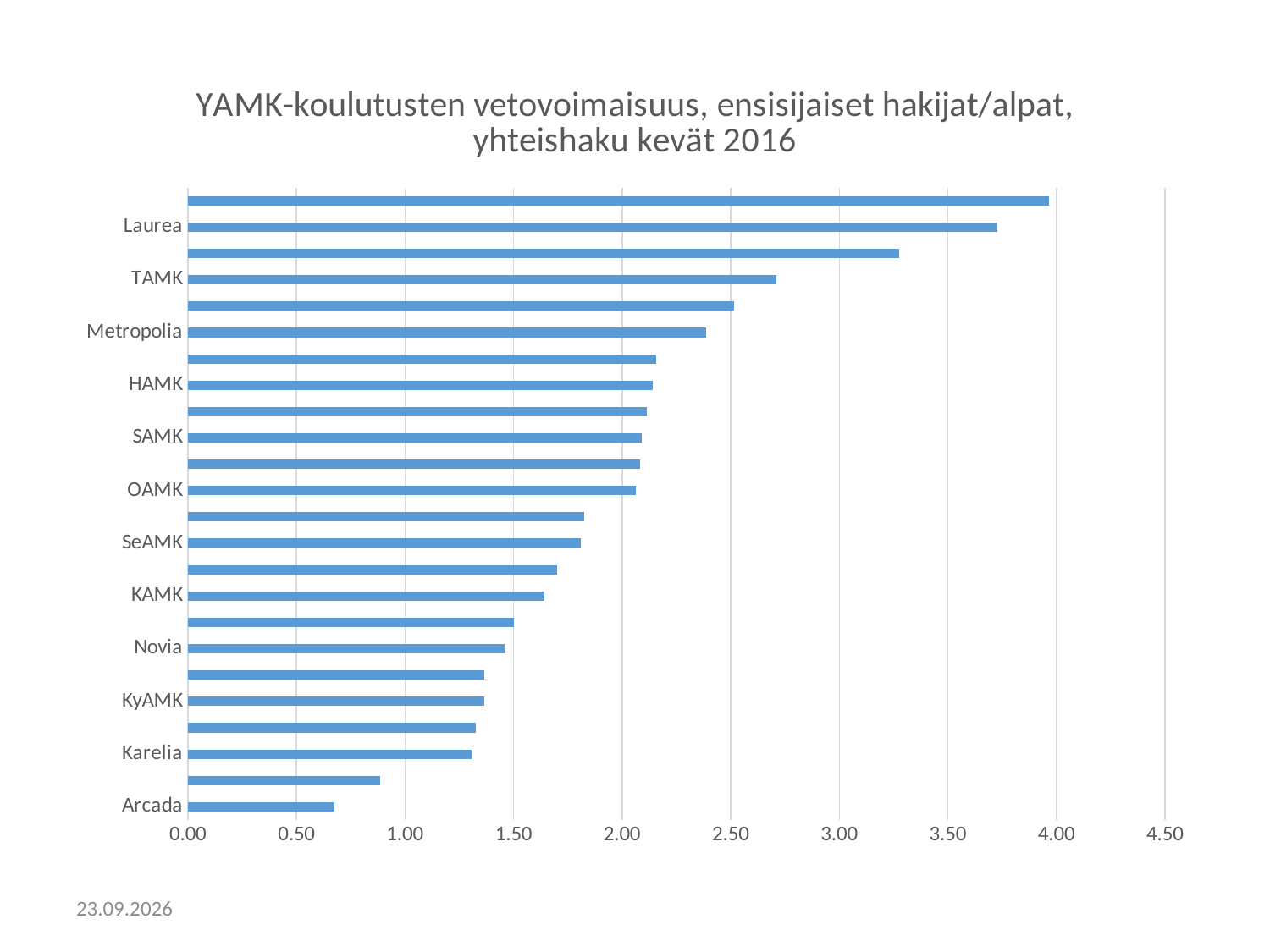
Is the value for Arcada greater or less than 1.00? less Which has a larger value, Laurea or TAMK? Laurea Which has a larger value, Karelia or Arcada? Karelia What kind of chart is shown on the slide? bar chart Is the value for Laurea greater or less than 3.50? greater Is the value for TAMK greater or less than 2.50? greater Do the bar values increase or decrease going from the top of the chart to the bottom? decrease What is the title of the chart? YAMK-koulutusten vetovoimaisuus, ensisijaiset hakijat/alpat, yhteishaku kevät 2016 Which category has the lowest value in the chart? Arcada